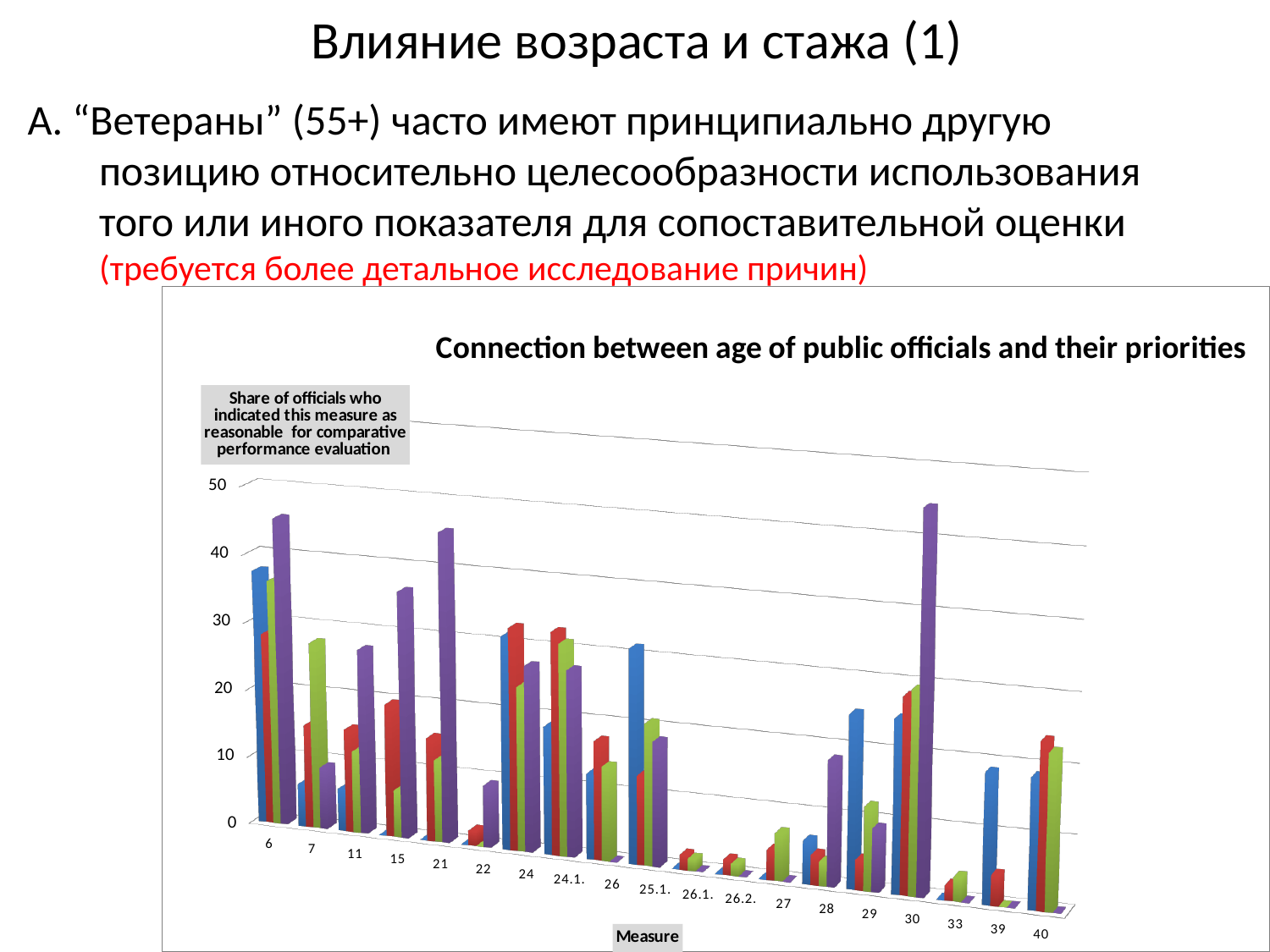
Is the value of the purple bar for measure 21 greater or less than 40? greater What is the label of the horizontal axis of the chart? Measure Is the value of the blue bar for measure 7 greater or less than 10? less What is the title of the chart? Connection between age of public officials and their priorities Is the value of the purple bar for measure 15 greater or less than 30? greater What kind of chart is shown on the slide? bar chart How many differently coloured bar series are plotted for each measure? 4 How many measure categories are shown along the x axis of the chart? 19